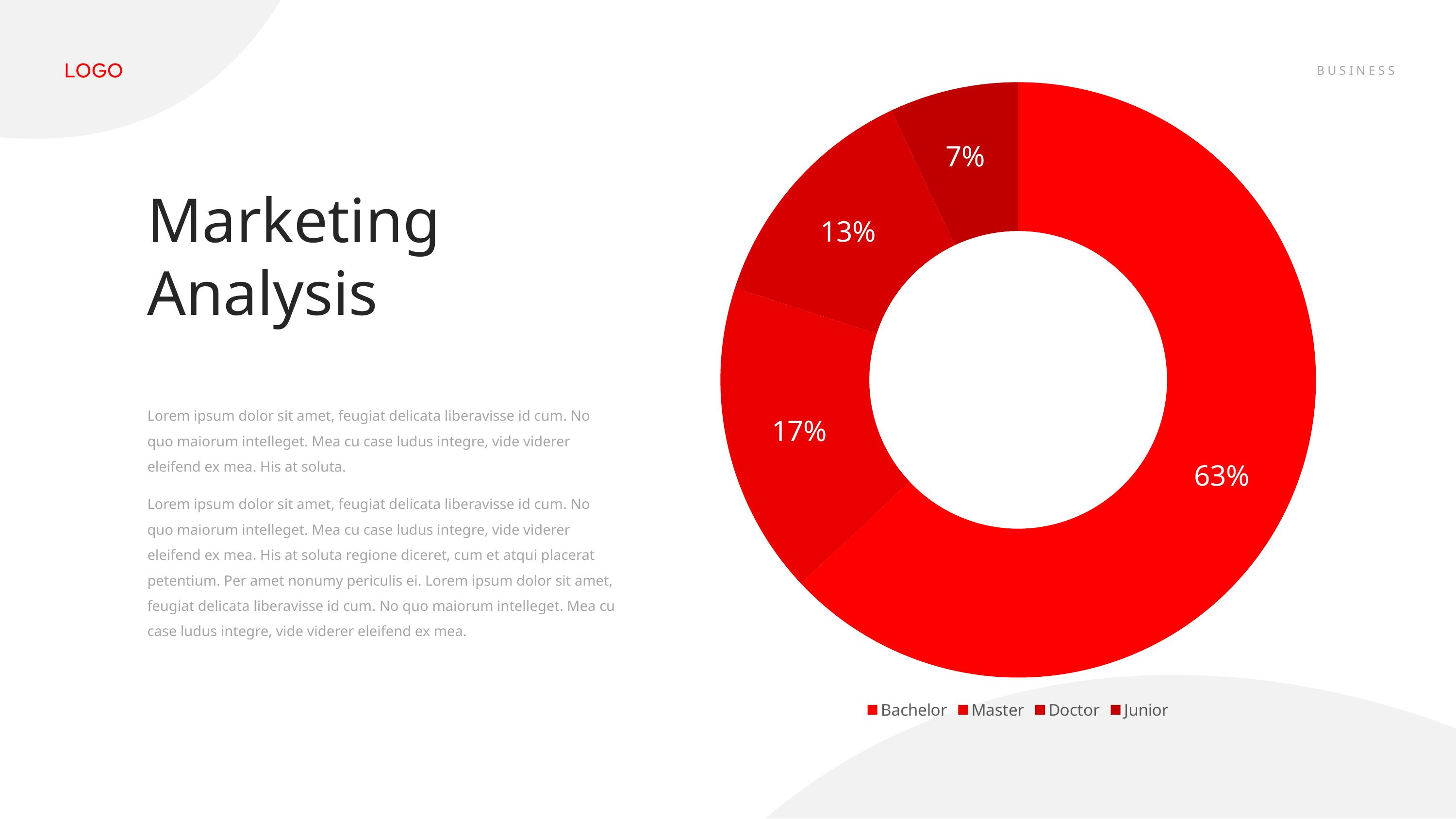
What percentage does the Bachelor slice show? 63% How many entries does the legend list? 4 Which category has the smallest share of the chart? Junior What percentage does the Doctor slice show? 13% What percentage does the Junior slice show? 7% What is the difference in percentage points between the Bachelor and Master slices? 46 What is the combined share of the Doctor and Junior slices? 20% Which slice is larger, Doctor or Junior? Doctor Which category has the largest share of the chart? Bachelor What kind of chart is shown on the slide? Doughnut chart What percentage does the Master slice show? 17% How many slices does the chart have? 4